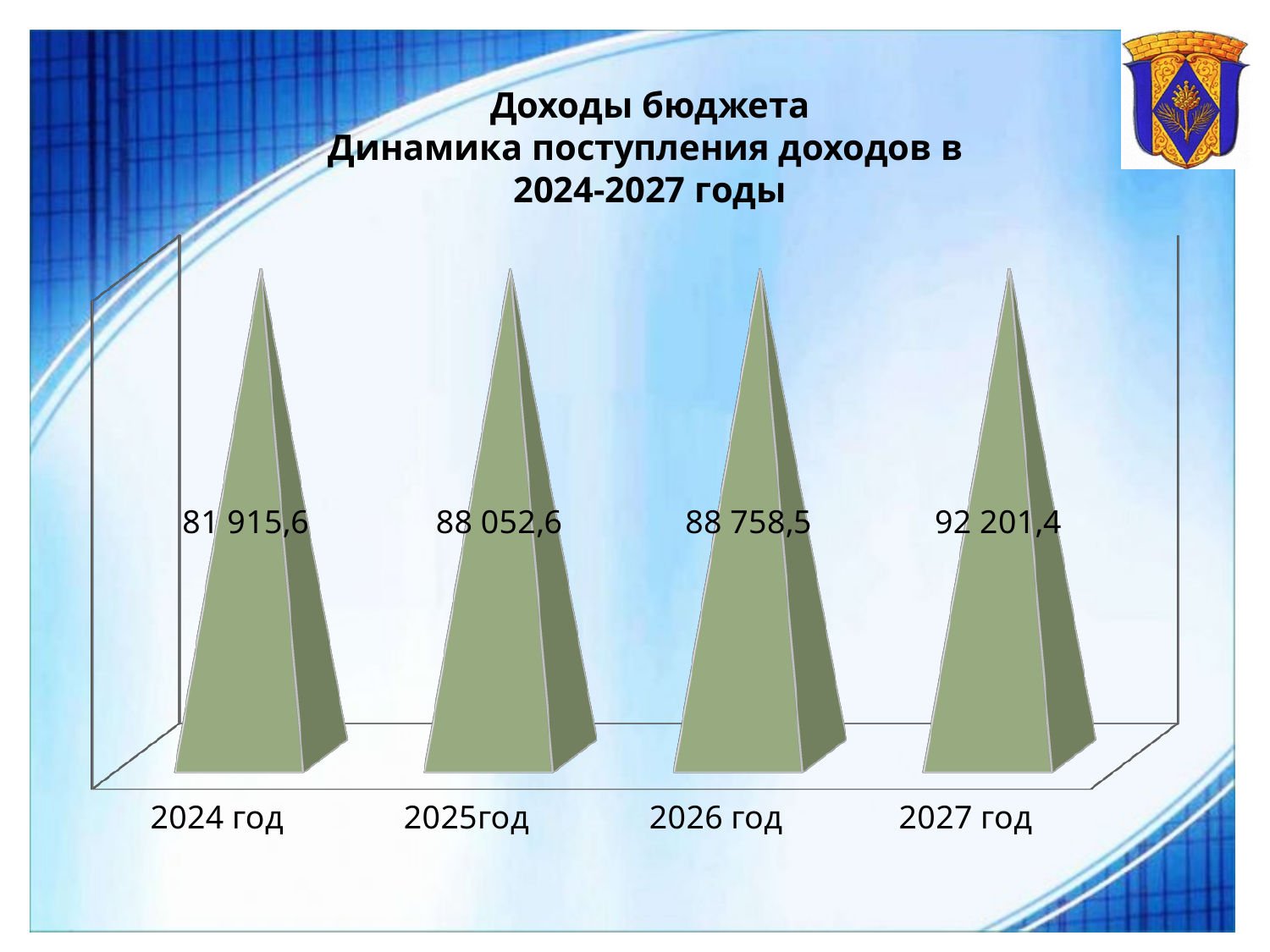
What is the difference between the values for 2027 год and 2024 год? 10 285,8 What is the value shown for 2025год? 88 052,6 What is the difference between the values for 2026 год and 2025год? 705,9 What is the value shown for 2026 год? 88 758,5 What is the value shown for 2027 год? 92 201,4 What is the value shown for 2024 год? 81 915,6 Which is larger, the value for 2025год or the value for 2026 год? 2026 год Which year has the highest value? 2027 год Do the values rise or fall from 2024 год to 2027 год? Rise How many years are shown on the chart? 4 Which year has the lowest value? 2024 год What kind of chart is shown on the slide? Bar chart